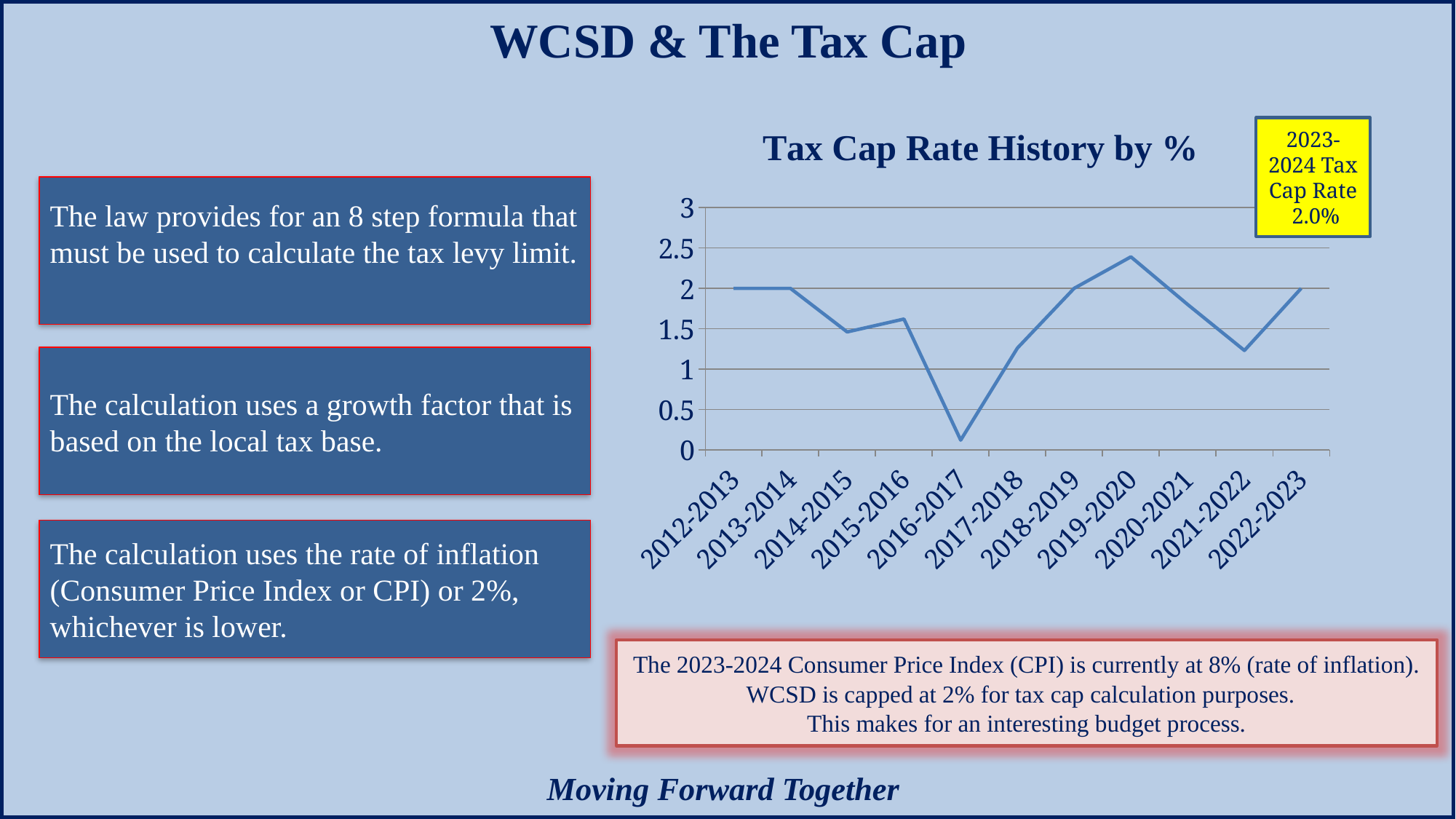
Do the values rise or fall from 2016-2017 to 2019-2020? rise Which school year has the highest tax cap rate in the chart? 2019-2020 How many school years are plotted on the x axis of the chart? 11 Is the value for 2019-2020 greater or less than 2? greater Which school year has the lowest tax cap rate in the chart? 2016-2017 What kind of chart is shown on the slide? line chart Is the value for 2021-2022 greater or less than 1.5? less Which has the larger tax cap rate, 2019-2020 or 2021-2022? 2019-2020 Is the value for 2016-2017 greater or less than 0.5? less What is the tax cap rate for 2022-2023 in the chart? 2 What is the title of the chart? Tax Cap Rate History by % What is the tax cap rate for 2012-2013 in the chart? 2